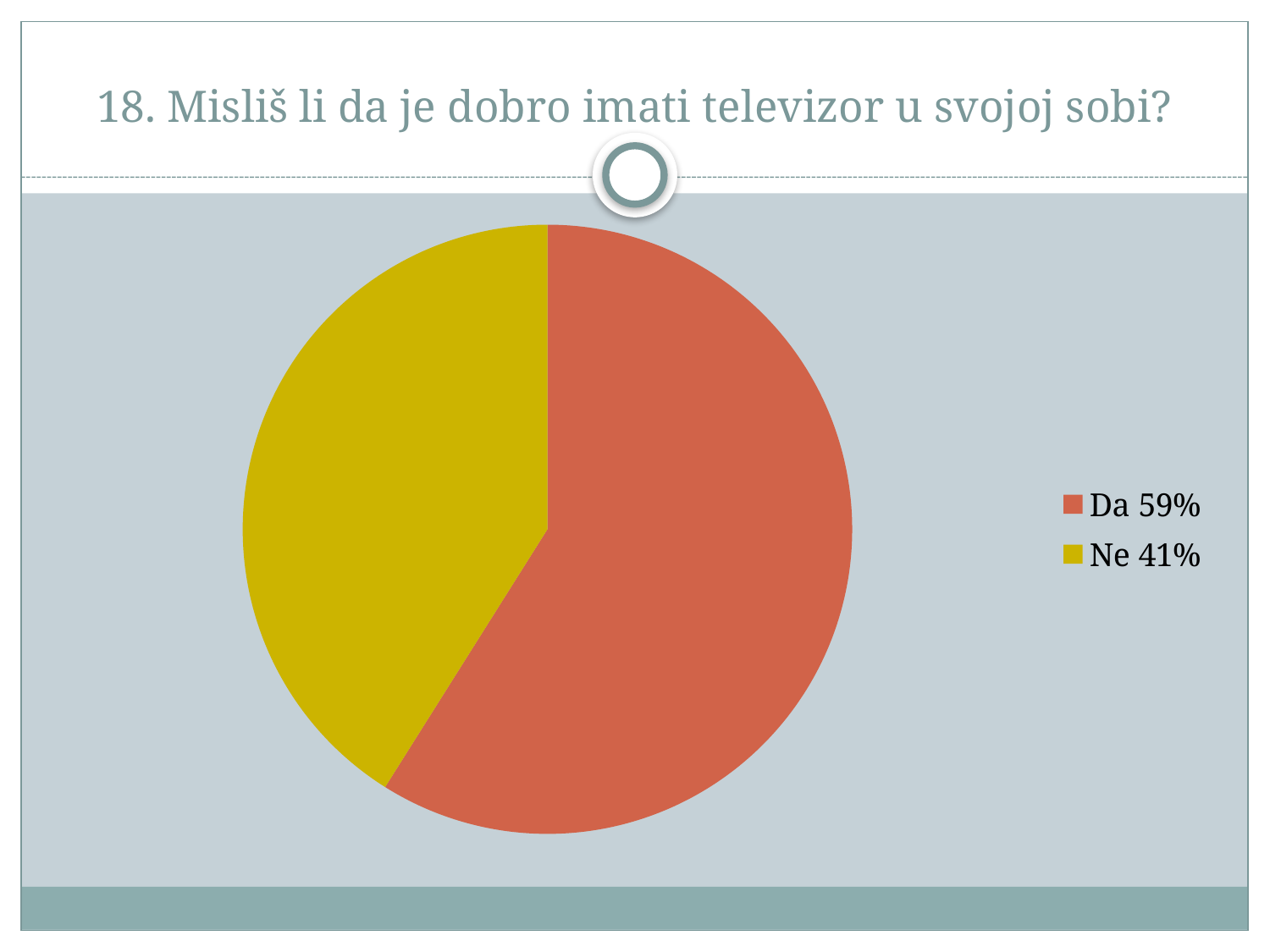
How many entries does the legend list? 2 Which slice is the smallest? Ne What share of the pie does "Da" represent? 59% What colour is the "Ne" slice? yellow What colour is the "Da" slice? red What kind of chart is shown on the slide? pie chart Which is larger, the "Da" slice or the "Ne" slice? Da What share of the pie does "Ne" represent? 41% What is the difference in percentage points between the "Da" and "Ne" slices? 18 Which slice is the largest? Da How many slices does the pie chart have? 2 Is the share for "Ne" greater or less than 50%? less